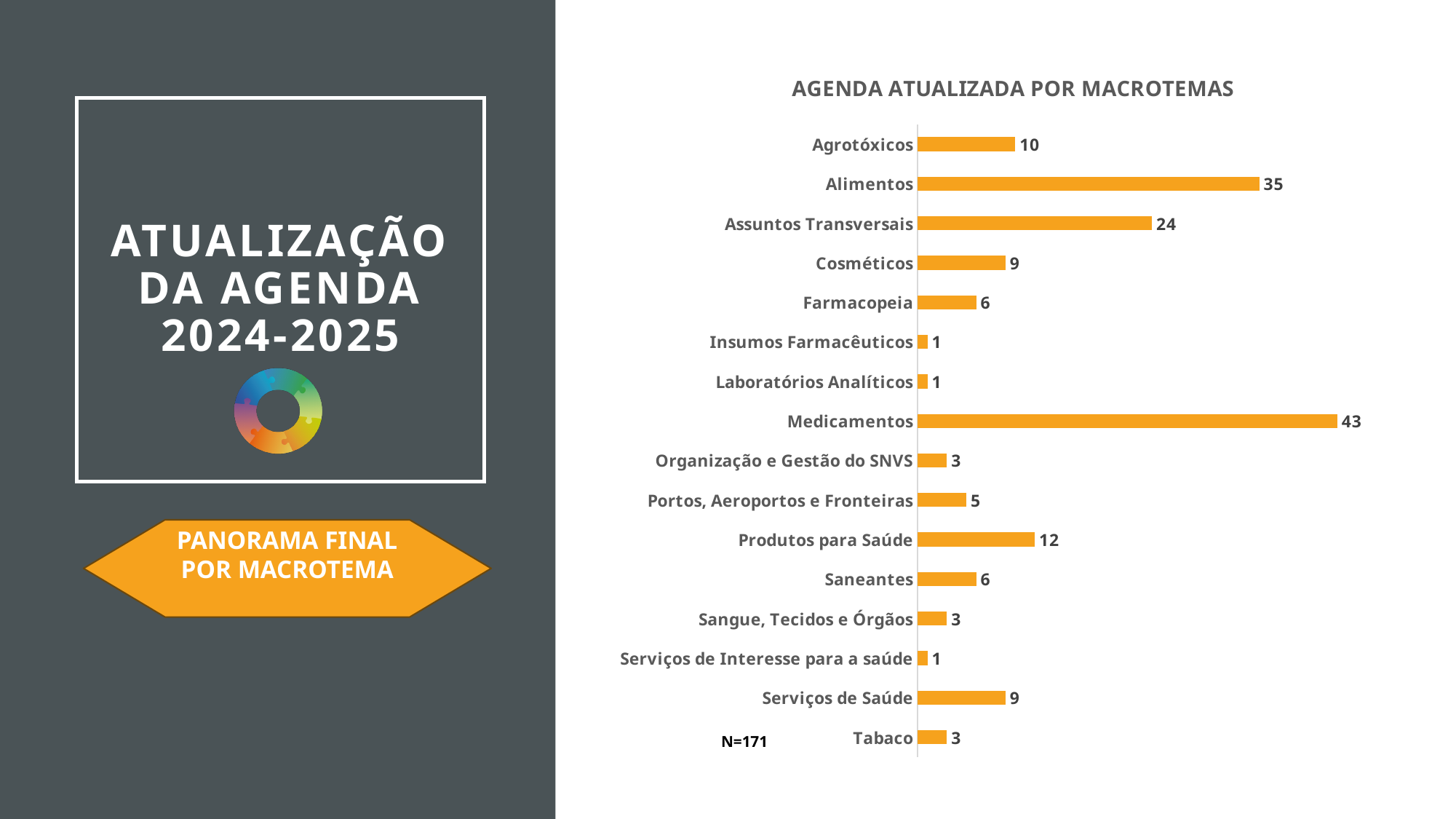
Which is larger, the value for Cosméticos or the value for Farmacopeia? Cosméticos What is the title of the chart? AGENDA ATUALIZADA POR MACROTEMAS What is the value for Produtos para Saúde? 12 What kind of chart is shown on the slide? Bar chart What is the value for Medicamentos? 43 What is the difference between the values for Medicamentos and Alimentos? 8 How many categories are shown in the chart? 16 What is the difference between the values for Assuntos Transversais and Agrotóxicos? 14 Which is larger, the value for Serviços de Saúde or the value for Tabaco? Serviços de Saúde What is the value for Alimentos? 35 What is the value for Portos, Aeroportos e Fronteiras? 5 Which category has the highest value? Medicamentos